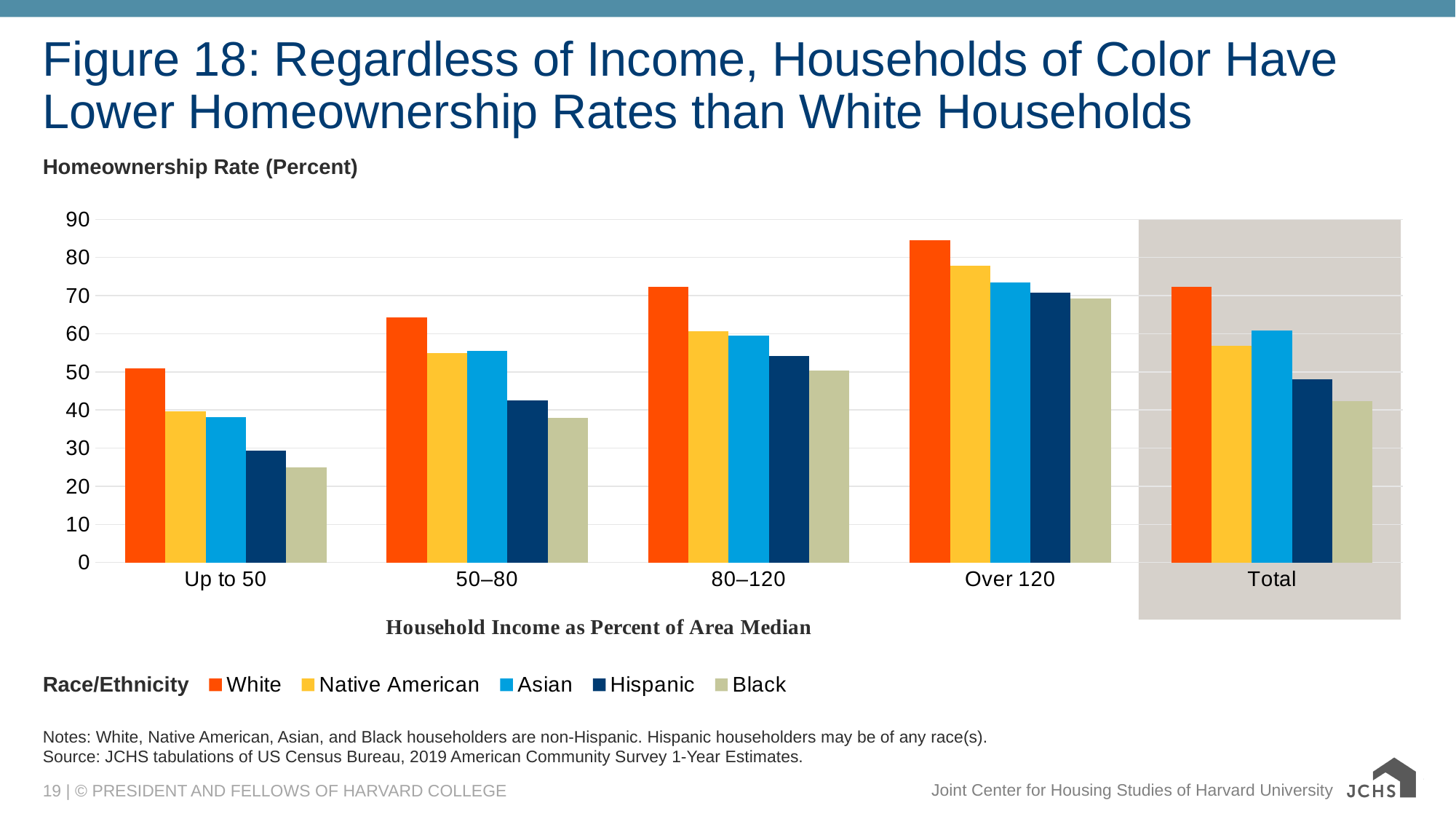
In which income category is the White homeownership rate highest? Over 120 How many income categories are shown on the x axis? 5 What kind of chart is shown on the slide? bar chart In the Total category, which is larger: the Asian rate or the Native American rate? Asian How many series does the legend list? 5 Is the White homeownership rate for the Over 120 category greater or less than 80? greater Do the White homeownership rates rise or fall as household income increases from Up to 50 to Over 120? rise In the Up to 50 category, which is larger: the White rate or the Black rate? White Is the Black homeownership rate for the Up to 50 category greater or less than 30? less In the Up to 50 income category, which race/ethnicity has the lowest homeownership rate? Black Is the Hispanic homeownership rate for the 50–80 category greater or less than 50? less What is the title of the x axis? Household Income as Percent of Area Median